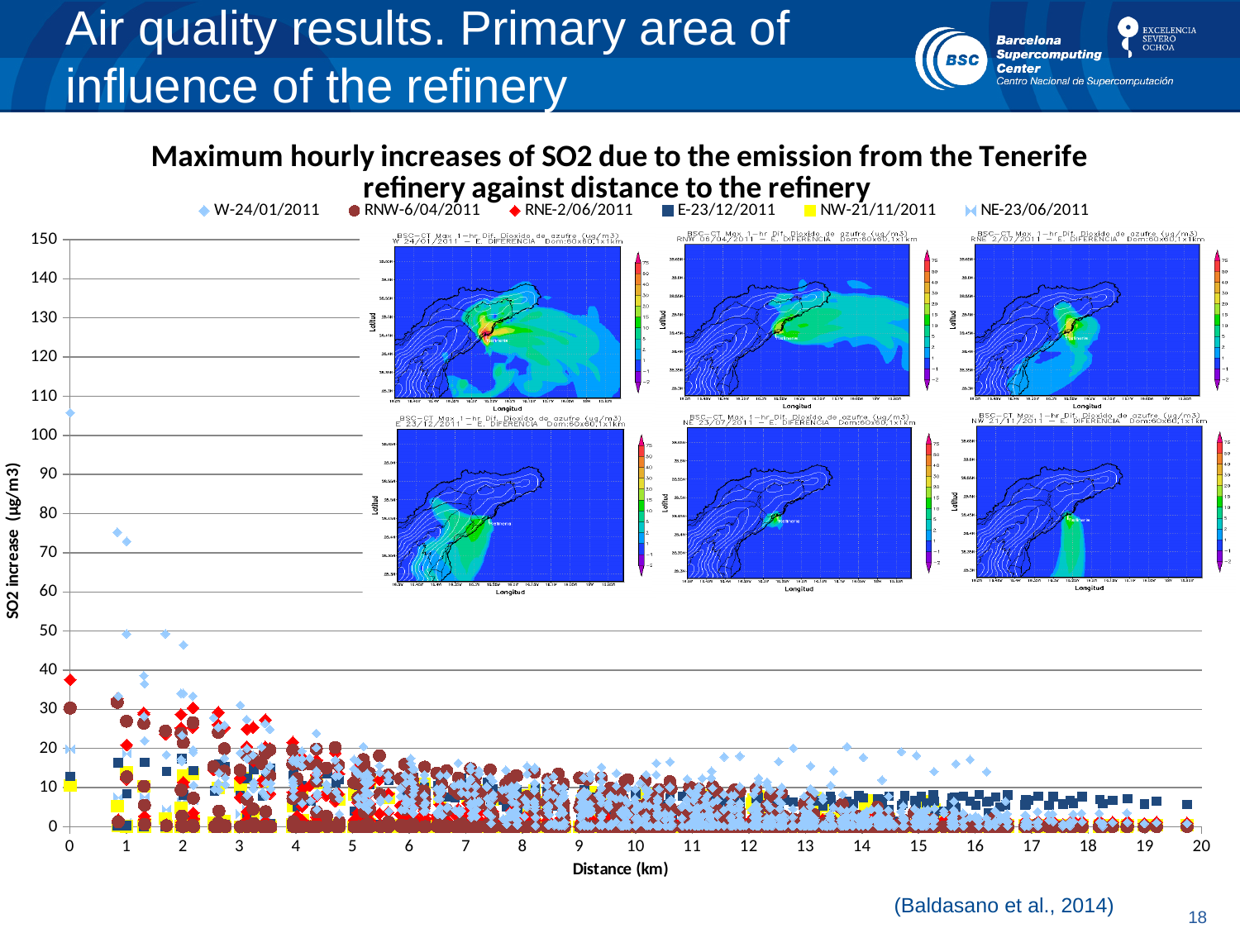
Do the SO2 increase values generally rise or fall as distance to the refinery increases? fall What is the label of the x axis of the chart? Distance (km) Which series has a higher maximum value, W-24/01/2011 or E-23/12/2011? W-24/01/2011 Which series reaches the highest SO2 increase value on the chart? W-24/01/2011 Is the highest plotted value for the NW-21/11/2011 series greater or less than 20? less Is the highest plotted value for the W-24/01/2011 series greater or less than 100? greater What is the title of the chart? Maximum hourly increases of SO2 due to the emission from the Tenerife refinery against distance to the refinery What is the maximum value shown on the y axis of the chart? 150 What kind of chart is shown on the slide? Scatter chart Is the highest plotted value for the RNE-2/06/2011 series greater or less than 50? less How many series does the chart legend list? 6